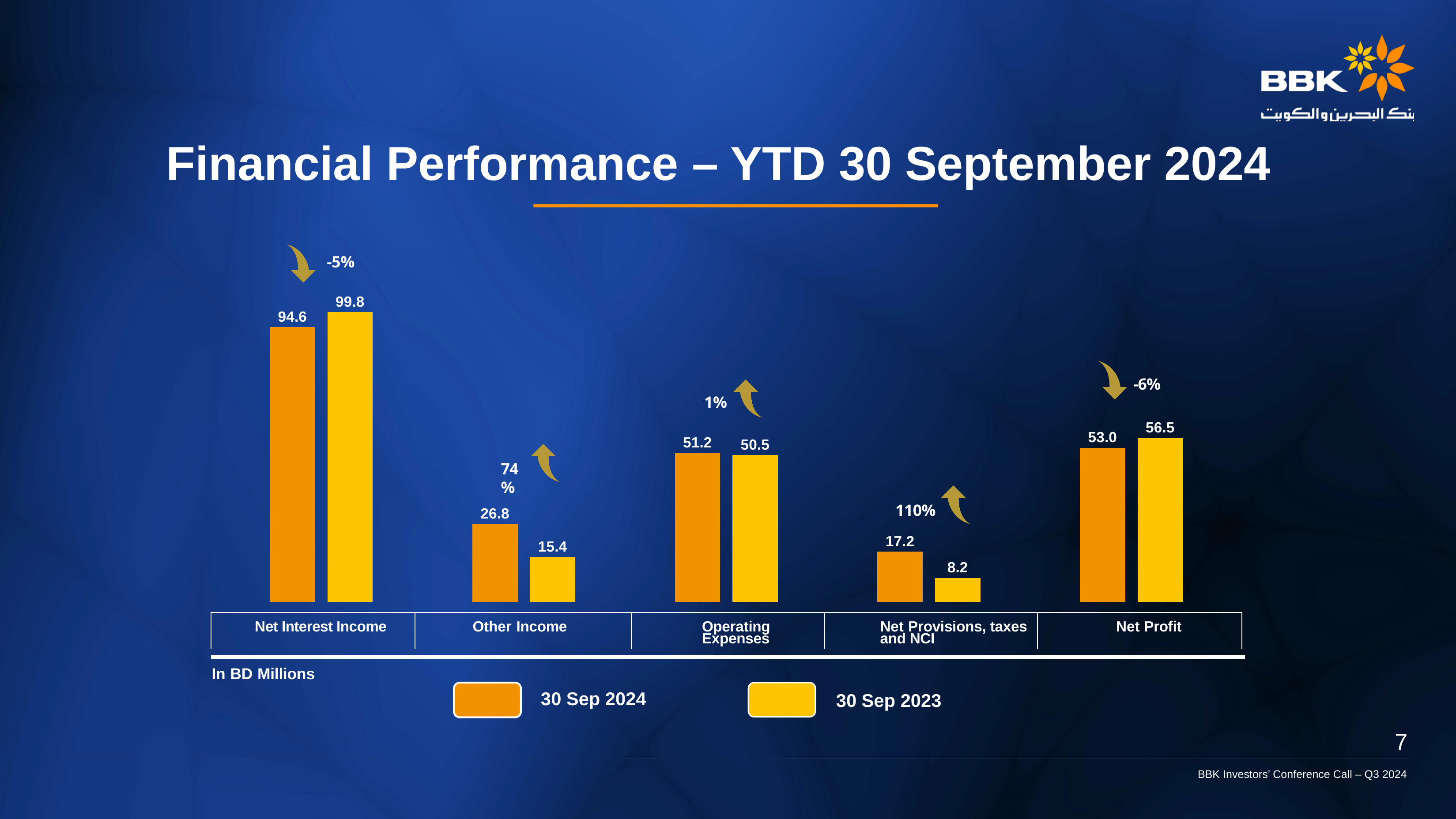
How many categories are shown on the x axis? 5 Which category has the lowest value for 30 Sep 2023? Net Provisions, taxes and NCI What is the Net Profit value for 30 Sep 2023? 56.5 Which is larger for Operating Expenses: the 30 Sep 2024 value or the 30 Sep 2023 value? 30 Sep 2024 What is the Net Interest Income value for 30 Sep 2024? 94.6 How many series does the legend list? 2 What kind of chart is shown on the slide? Bar chart Which category has the highest value for 30 Sep 2024? Net Interest Income What is the difference between the Net Provisions, taxes and NCI values for 30 Sep 2024 and 30 Sep 2023? 9.0 What percentage change is shown above the Net Provisions, taxes and NCI bars? 110% What is the Other Income value for 30 Sep 2023? 15.4 What is the difference between the Net Profit values for 30 Sep 2023 and 30 Sep 2024? 3.5